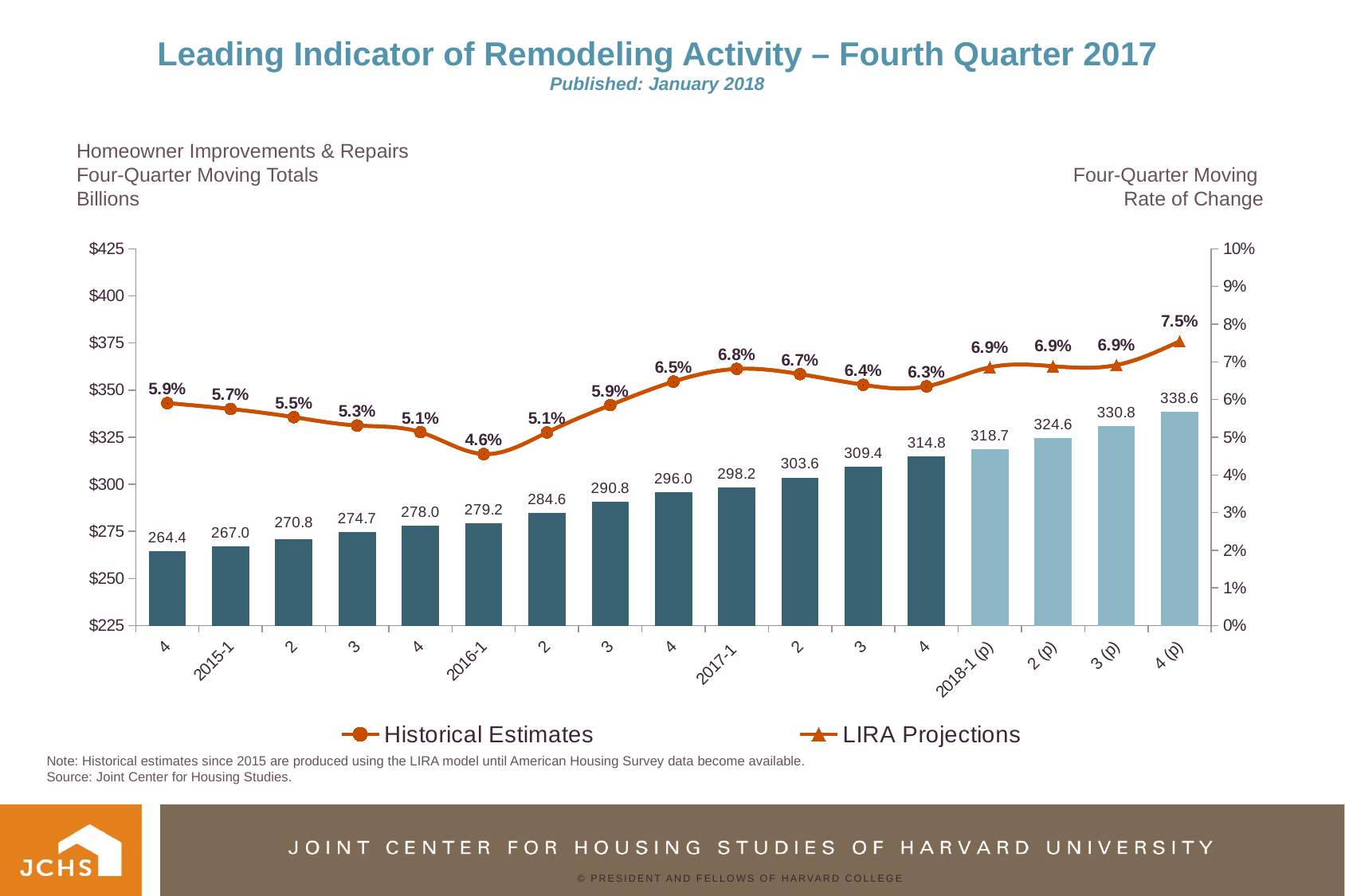
Do the four-quarter moving total bars rise or fall from left to right across the chart? rise What are the two entries listed in the legend? Historical Estimates and LIRA Projections What is the four-quarter moving total (in billions) for 2017-1? 298.2 How many series does the legend list? 2 Which quarter has the highest four-quarter moving total bar? 4 (p) of 2018 Is the four-quarter moving total bar for 2015-1 greater or less than $275? less What is the difference between the four-quarter moving total for 2018 4 (p) and for 2017 quarter 4? 23.8 How many quarters (bars) are plotted on the chart? 17 Which quarter has the lowest four-quarter moving rate of change on the line? 2016-1 What kind of chart is shown on the slide? Combined bar and line chart Which is larger, the four-quarter moving total for 2017 quarter 2 or for 2016 quarter 2? 2017 quarter 2 What is the four-quarter moving rate of change shown for 2016-1? 4.6%